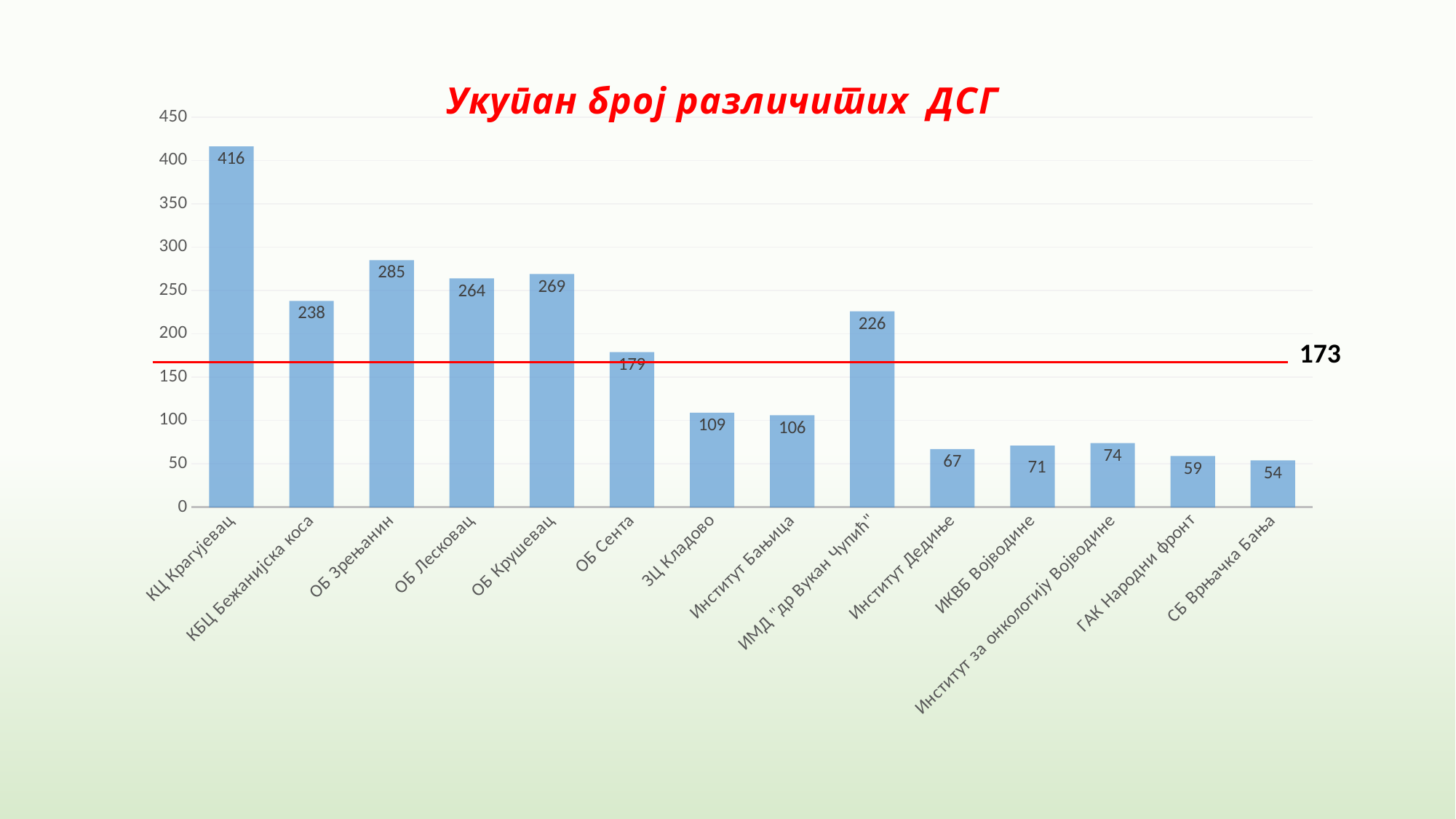
Which category has the lowest value? СБ Врњачка Бања What is the value for Институт за онкологију Војводине? 74 Which category has the highest value? КЦ Крагујевац Is the value for ИМД "др Вукан Чупић" greater or less than 200? greater Which is larger, the value for ЗЦ Кладово or the value for Институт Бањица? ЗЦ Кладово What is the value for КЦ Крагујевац? 416 What is the value for ОБ Сента? 179 How many categories are shown on the x axis? 14 What is the difference between the values for ОБ Зрењанин and ОБ Лесковац? 21 What kind of chart is shown on the slide? bar chart What is the title of the chart? Укупан број различитих ДСГ What value is labelled on the red horizontal line across the chart? 173